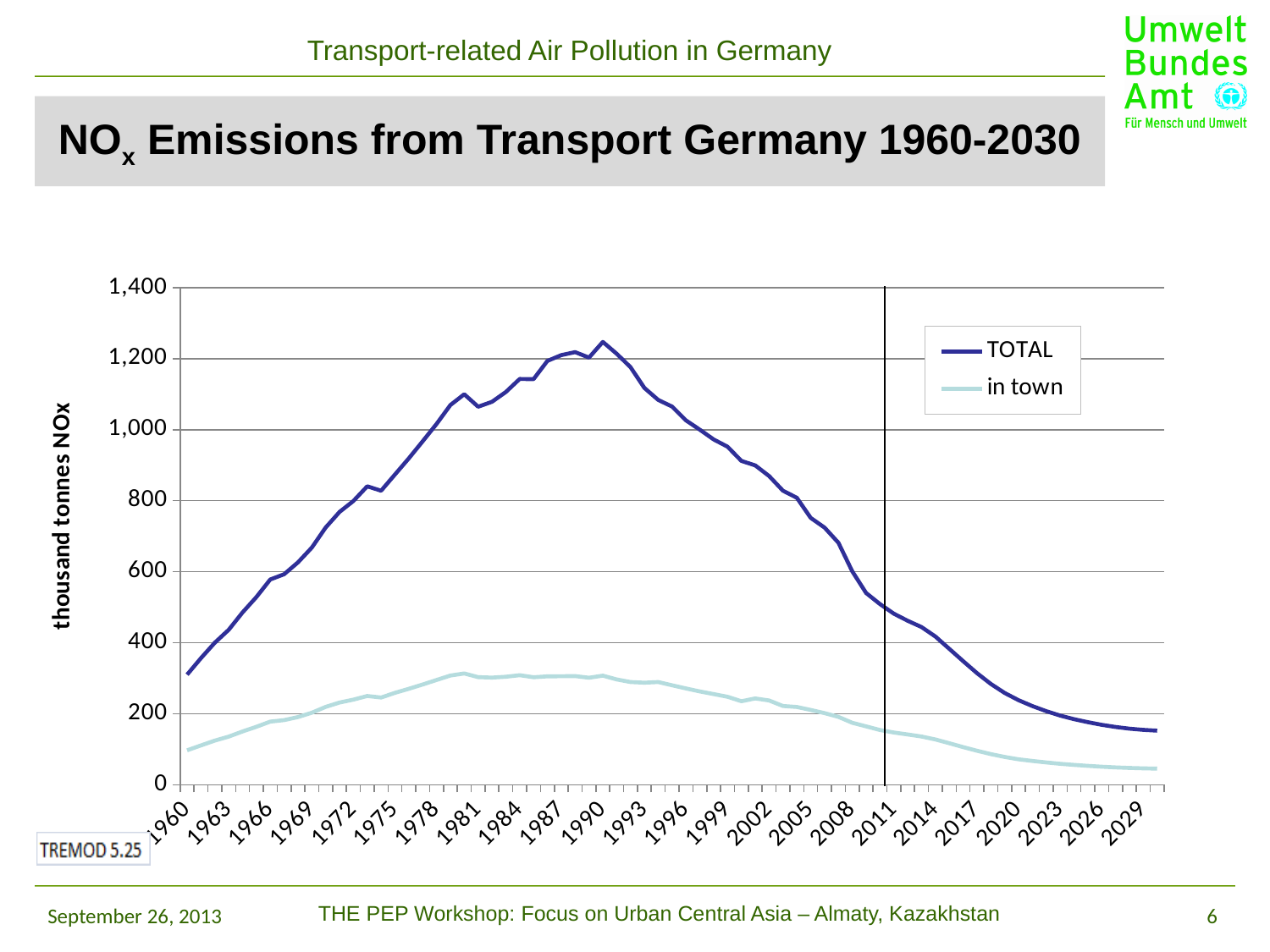
What is the label of the vertical axis of the chart? thousand tonnes NOx What are the two series named in the chart legend? TOTAL and in town Does the TOTAL series rise or fall between 1990 and 2029? fall Is the 'in town' value for 1960 greater or less than 200? less What kind of chart is shown on the slide? line chart Is the 'in town' value for 1981 greater or less than 400? less Which series has the higher value in 1990, TOTAL or in town? TOTAL How many series does the chart legend list? 2 Is the TOTAL value for 1990 greater or less than 1,200? greater Does the TOTAL series rise or fall between 1960 and 1990? rise